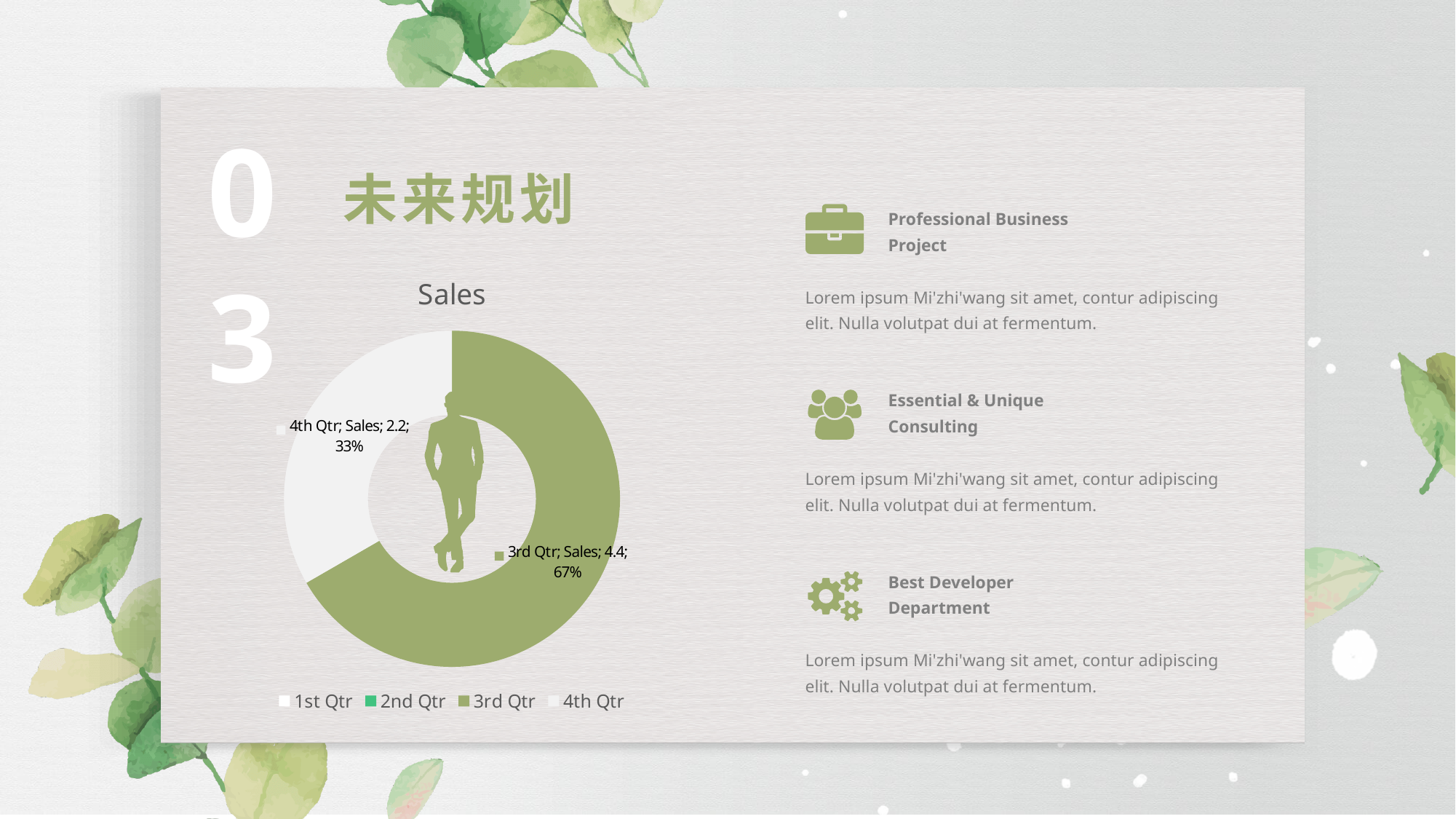
Which quarter has the smallest slice in the Sales chart? 4th Qtr How many slices are plotted in the Sales chart? 2 Which is larger in the Sales chart, 3rd Qtr or 4th Qtr? 3rd Qtr Which quarter has the largest slice in the Sales chart? 3rd Qtr What is the difference between the 3rd Qtr and 4th Qtr values in the Sales chart? 2.2 What is the value for 3rd Qtr in the Sales chart? 4.4 What kind of chart is the Sales chart? doughnut chart What share of the Sales chart does the 4th Qtr slice represent? 33% How many entries does the legend of the Sales chart list? 4 What share of the Sales chart does the 3rd Qtr slice represent? 67% What is the value for 4th Qtr in the Sales chart? 2.2 What is the title of the chart on the slide? Sales